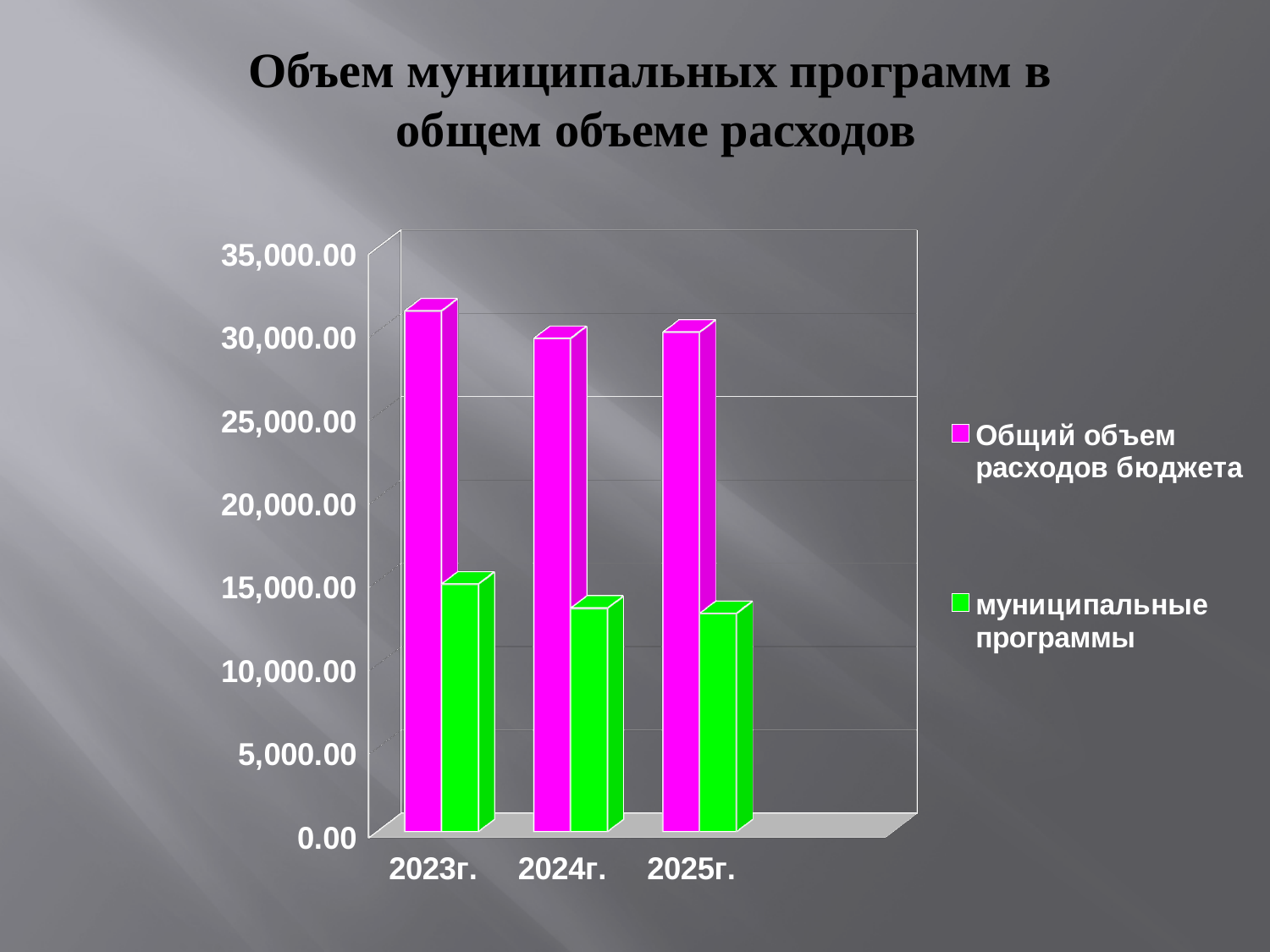
Which year has the highest value for Общий объем расходов бюджета? 2023г. Is the value for муниципальные программы in 2025г. greater or less than 10,000.00? greater How many series does the legend list? 2 Is the value for Общий объем расходов бюджета in 2023г. greater or less than 30,000.00? greater In 2025г., which is larger: Общий объем расходов бюджета or муниципальные программы? Общий объем расходов бюджета Is the value for муниципальные программы in 2024г. greater or less than 15,000.00? less How many year categories are shown on the x axis? 3 What is the title of the chart? Объем муниципальных программ в общем объеме расходов What kind of chart is shown on the slide? bar chart What colour represents муниципальные программы in the legend? green Do the values for муниципальные программы rise or fall from 2023г. to 2025г.? fall Which year has the highest value for муниципальные программы? 2023г.